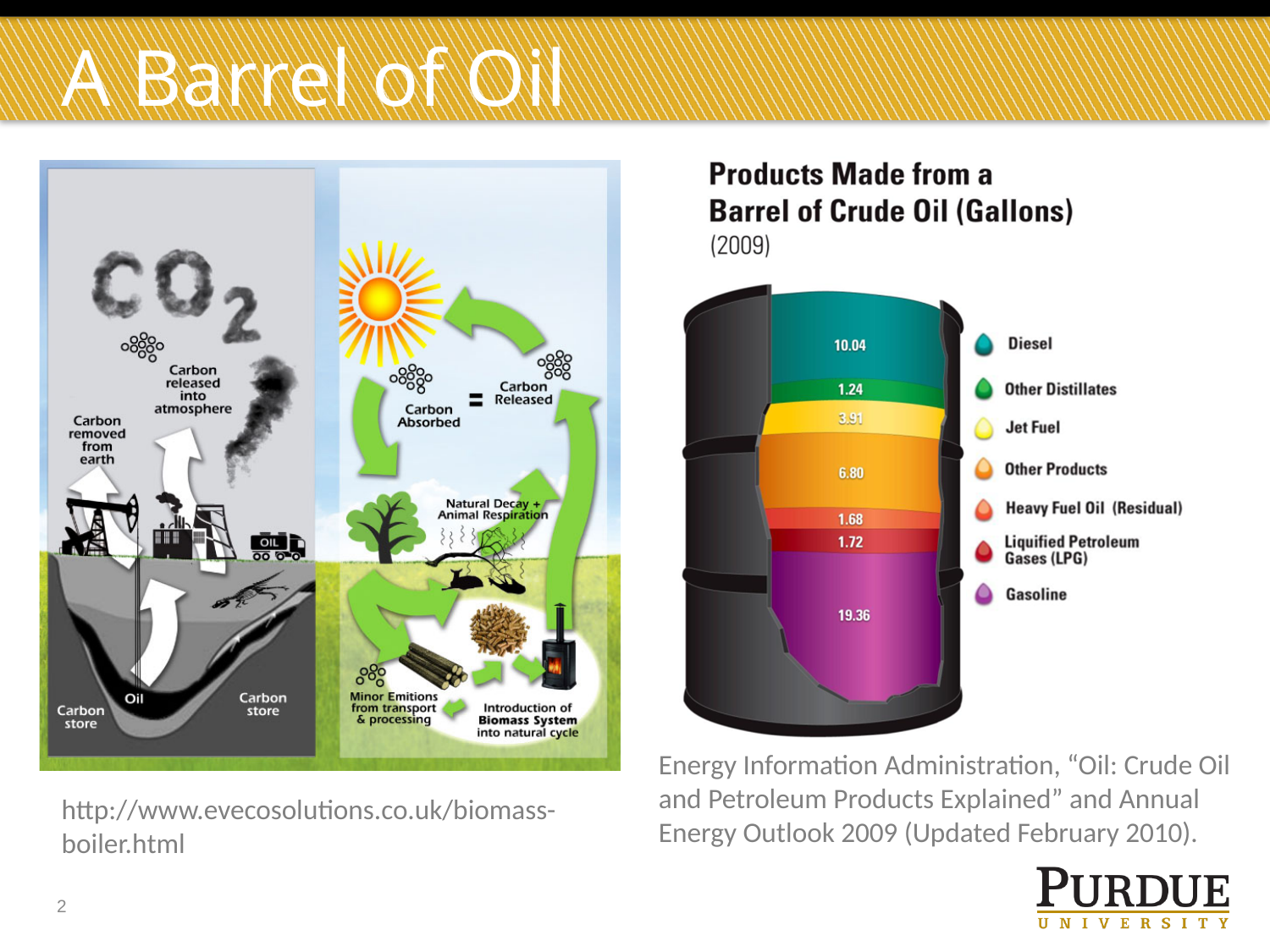
In the 'Products Made from a Barrel of Crude Oil (Gallons)' chart, how many more gallons of Gasoline than Diesel are there? 9.32 In the 'Products Made from a Barrel of Crude Oil (Gallons)' chart, which product has the smallest number of gallons? Other Distillates In the 'Products Made from a Barrel of Crude Oil (Gallons)' chart, what is the difference between Other Products and Jet Fuel? 2.89 What year does the 'Products Made from a Barrel of Crude Oil (Gallons)' chart refer to? 2009 In the 'Products Made from a Barrel of Crude Oil (Gallons)' chart, what is the value for Jet Fuel? 3.91 In the 'Products Made from a Barrel of Crude Oil (Gallons)' chart, what is the total number of gallons across all products? 44.75 In the 'Products Made from a Barrel of Crude Oil (Gallons)' chart, how many product categories are shown? 7 In the 'Products Made from a Barrel of Crude Oil (Gallons)' chart, how many gallons of Gasoline come from a barrel? 19.36 In the 'Products Made from a Barrel of Crude Oil (Gallons)' chart, which is larger, Other Products or Jet Fuel? Other Products In the 'Products Made from a Barrel of Crude Oil (Gallons)' chart, how many gallons of Diesel are shown? 10.04 In the 'Products Made from a Barrel of Crude Oil (Gallons)' chart, what is the value for Heavy Fuel Oil (Residual)? 1.68 In the 'Products Made from a Barrel of Crude Oil (Gallons)' chart, which product has the largest number of gallons? Gasoline